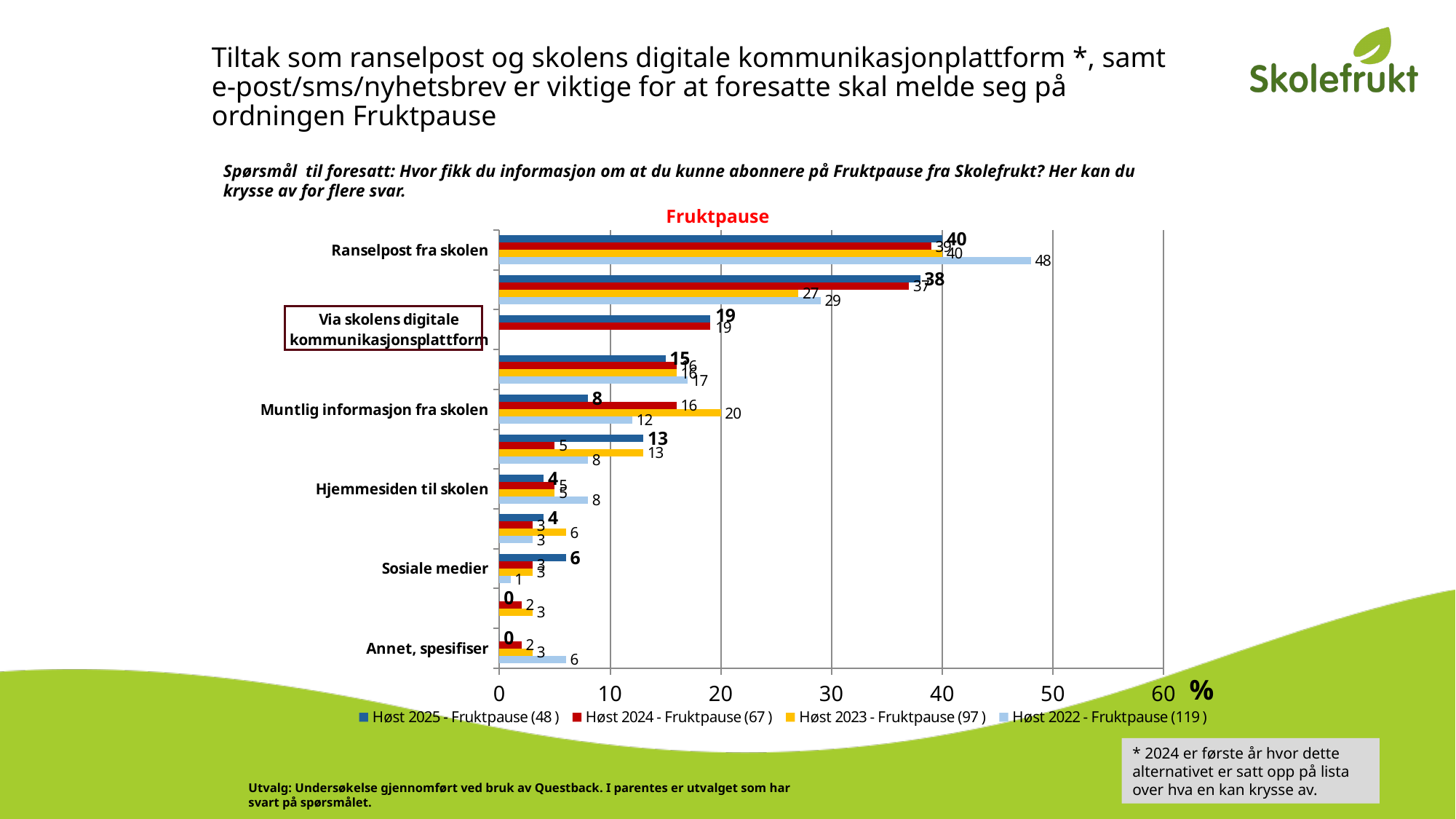
What is the Høst 2025 value for Muntlig informasjon fra skolen? 8 Which series has the highest value for Ranselpost fra skolen? Høst 2022 - Fruktpause (119) What is the Høst 2022 value for Hjemmesiden til skolen? 8 What is the Høst 2025 value for Via skolens digitale kommunikasjonsplattform? 19 What is the Høst 2025 value for Ranselpost fra skolen? 40 What is the Høst 2023 value for Muntlig informasjon fra skolen? 20 How many series does the legend list? 4 For Muntlig informasjon fra skolen, which is larger: the Høst 2023 value or the Høst 2024 value? Høst 2023 What is the difference between the Høst 2022 and Høst 2025 values for Ranselpost fra skolen? 8 What is the Høst 2025 value for Sosiale medier? 6 What is the Høst 2025 value for Annet, spesifiser? 0 What is the Høst 2022 value for Ranselpost fra skolen? 48